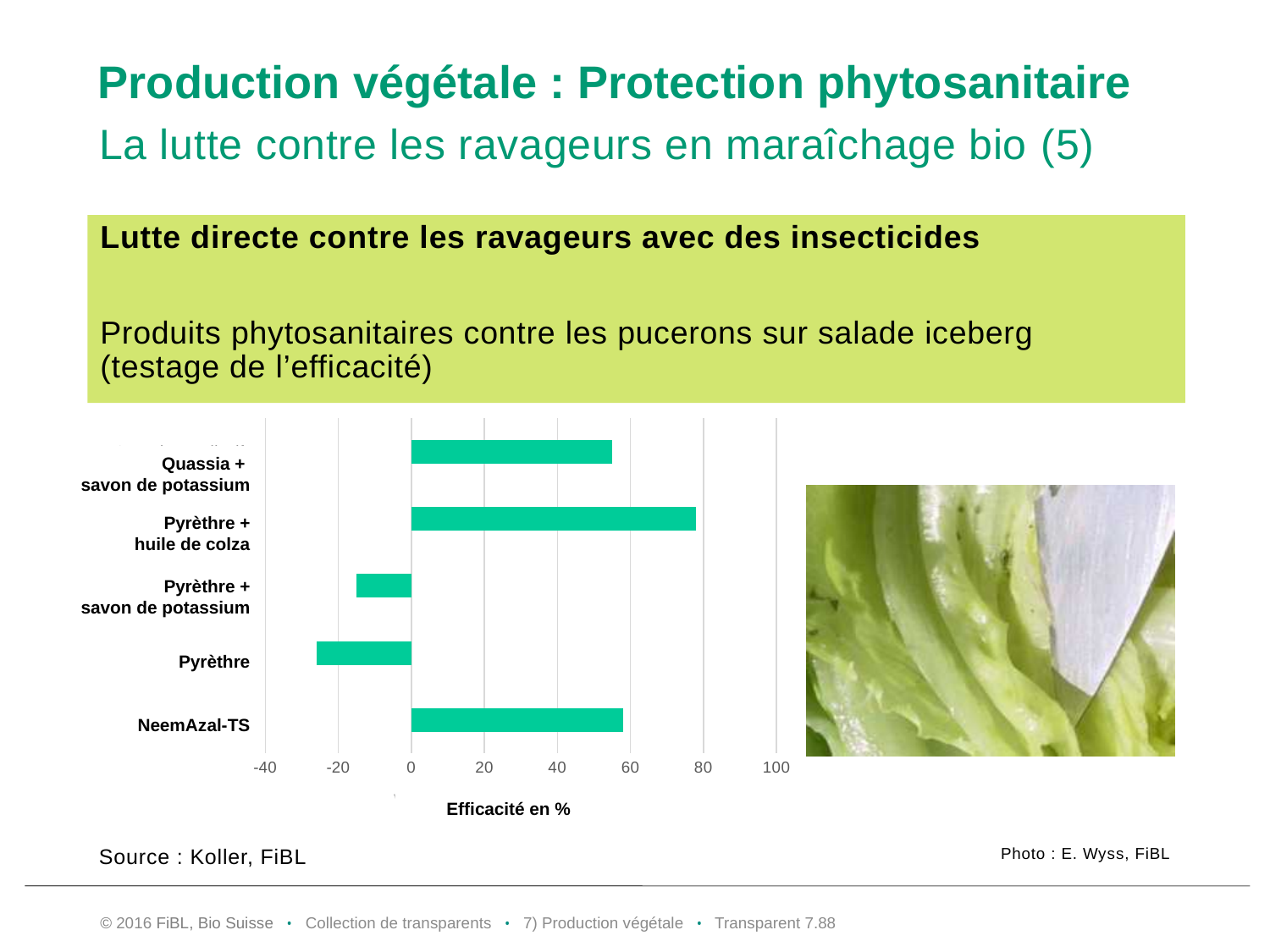
Which has a larger efficacité, Pyrèthre + huile de colza or Quassia + savon de potassium? Pyrèthre + huile de colza Is the value for Pyrèthre + huile de colza greater or less than 60? greater What kind of chart is shown on the slide? bar chart Is the value for NeemAzal-TS greater or less than 80? less Is the value for Pyrèthre greater or less than -20? less Which product has the lowest efficacité in the chart? Pyrèthre How many products are compared in the chart? 5 Which product has the highest efficacité in the chart? Pyrèthre + huile de colza Which has a larger efficacité, NeemAzal-TS or Pyrèthre? NeemAzal-TS What is the label of the horizontal axis of the chart? Efficacité en %